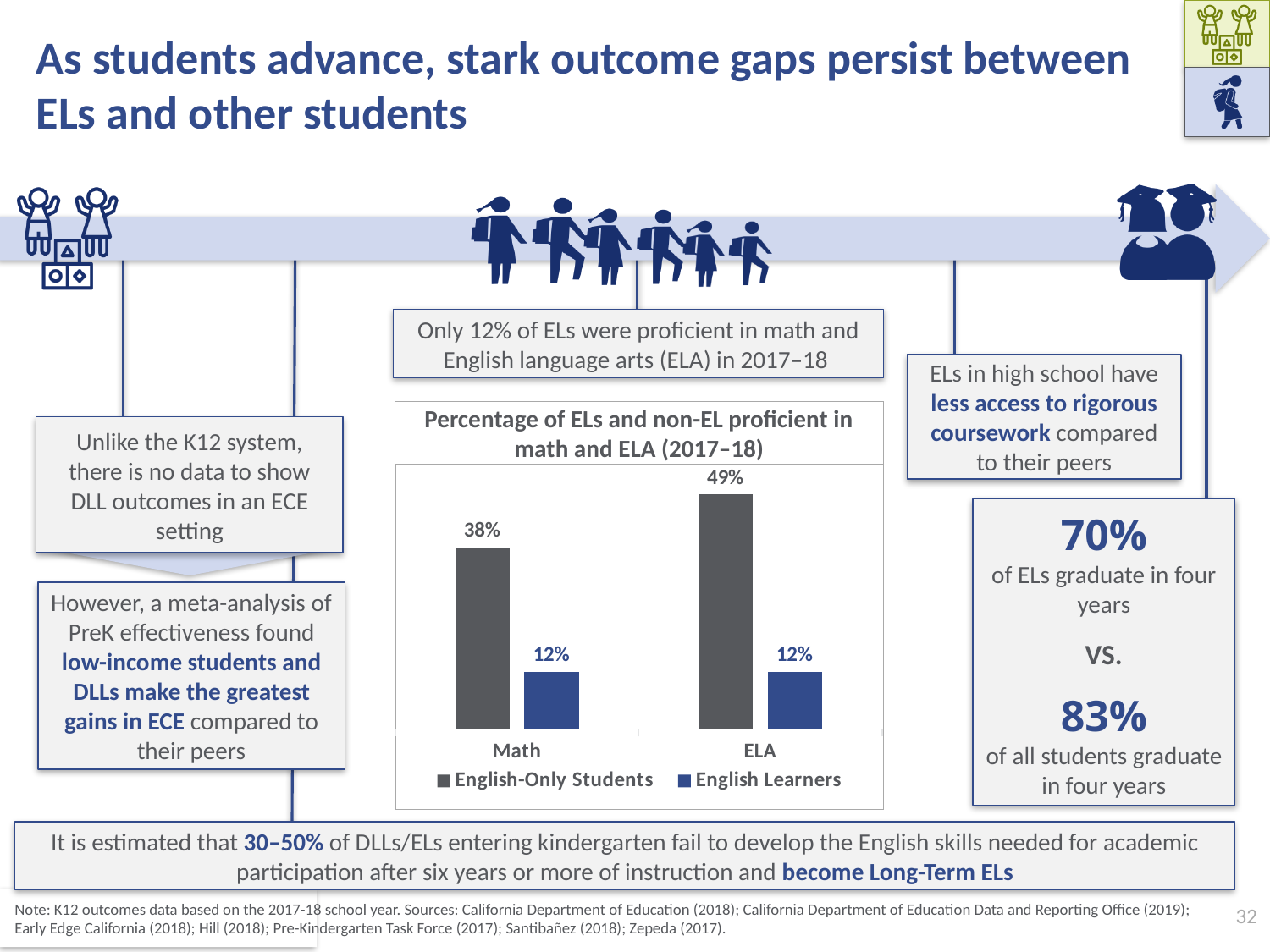
What is the title of the chart? Percentage of ELs and non-EL proficient in math and ELA (2017–18) How many series does the chart legend list? 2 What kind of chart is shown on the slide? Bar chart What percentage of English Learners were proficient in ELA? 12% How many categories are shown on the x axis of the chart? 2 What percentage of English-Only Students were proficient in ELA? 49% What is the difference between English-Only Students and English Learners in Math? 26% Which is larger: English-Only Students in Math or English-Only Students in ELA? English-Only Students in ELA What percentage of English-Only Students were proficient in Math? 38% Which series is shown in blue in the chart? English Learners What is the difference between English-Only Students and English Learners in ELA? 37% Which category has the highest value for English-Only Students? ELA